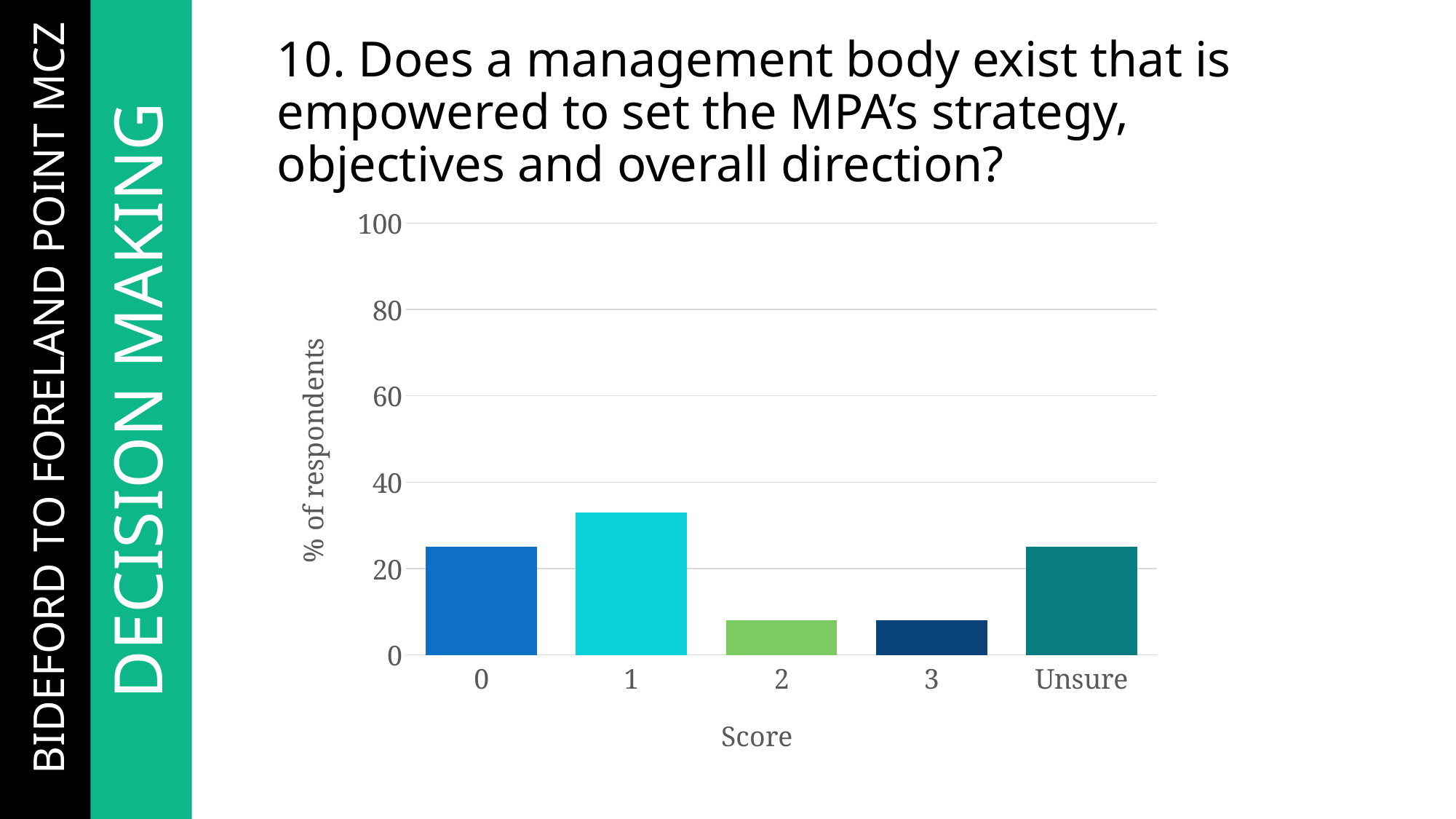
Is the value for score 1 greater or less than 40? less Is the value for score 3 greater or less than 20? less Which is larger, the value for Unsure or the value for score 3? Unsure How many score categories are shown on the x axis? 5 What is the label of the y axis? % of respondents What kind of chart is shown on the slide? bar chart Is the value for Unsure greater or less than 20? greater Which score category has the highest percentage of respondents? 1 Which is larger, the value for score 1 or the value for score 0? score 1